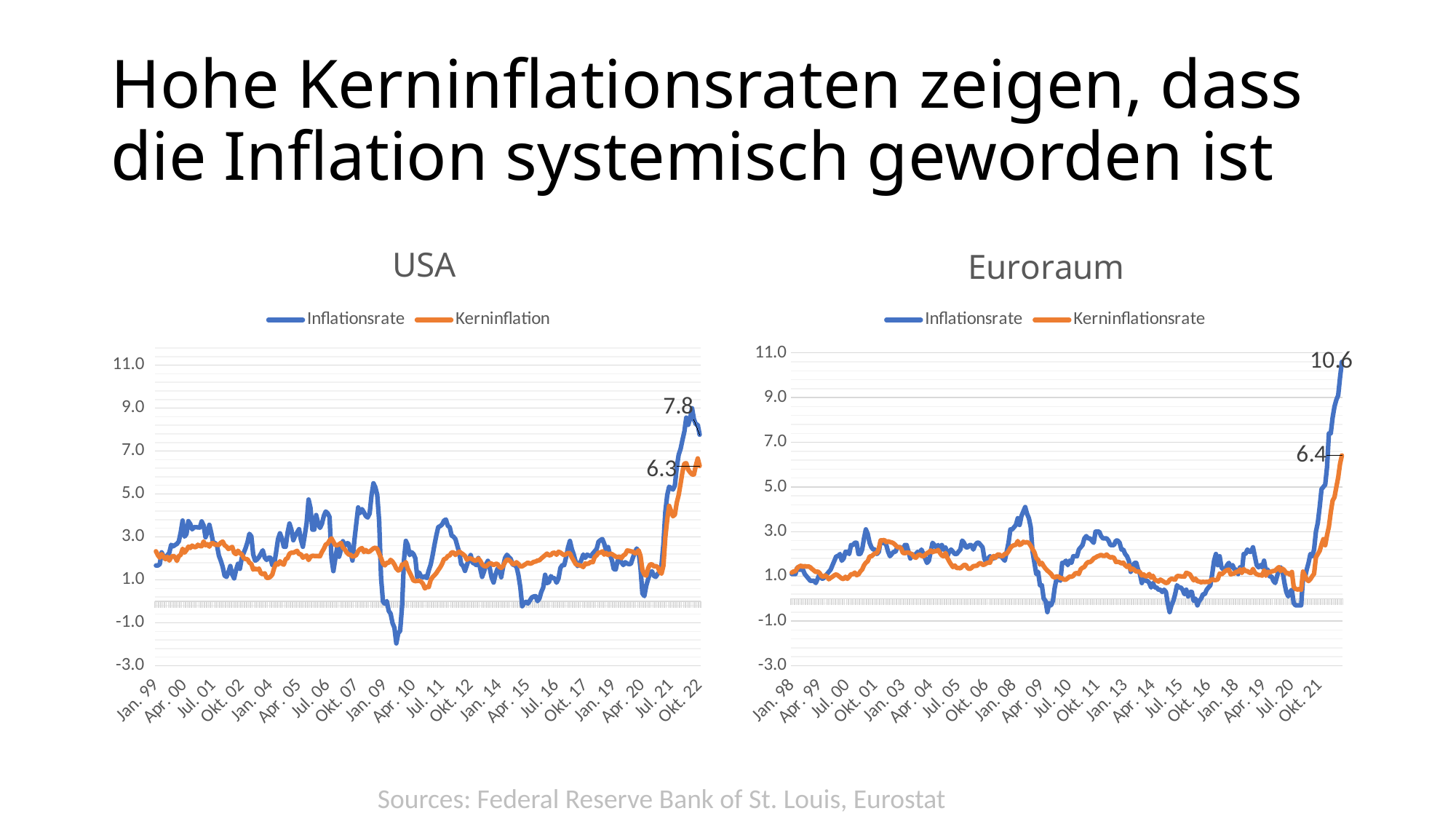
How many series does the legend of the Euroraum chart list? 2 On the Euroraum chart, what is the latest labelled value of the Kerninflationsrate series? 6.4 On the USA chart, what is the latest labelled value of the Kerninflation series? 6.3 What kind of chart is the USA chart? line chart On the USA chart, is the lowest value of the Inflationsrate series (around 2009) greater or less than -1.0? less On the Euroraum chart, which colour is used for the Kerninflationsrate series? orange On the USA chart, what is the difference between the labelled Inflationsrate value (7.8) and the labelled Kerninflation value (6.3)? 1.5 Which chart shows the higher labelled Inflationsrate value, USA or Euroraum? Euroraum On the USA chart, what is the latest labelled value of the Inflationsrate series? 7.8 On the USA chart, is the labelled Inflationsrate value greater or less than the labelled Kerninflation value? greater On the Euroraum chart, what is the difference between the labelled Inflationsrate value (10.6) and the labelled Kerninflationsrate value (6.4)? 4.2 On the Euroraum chart, what is the latest labelled value of the Inflationsrate series? 10.6